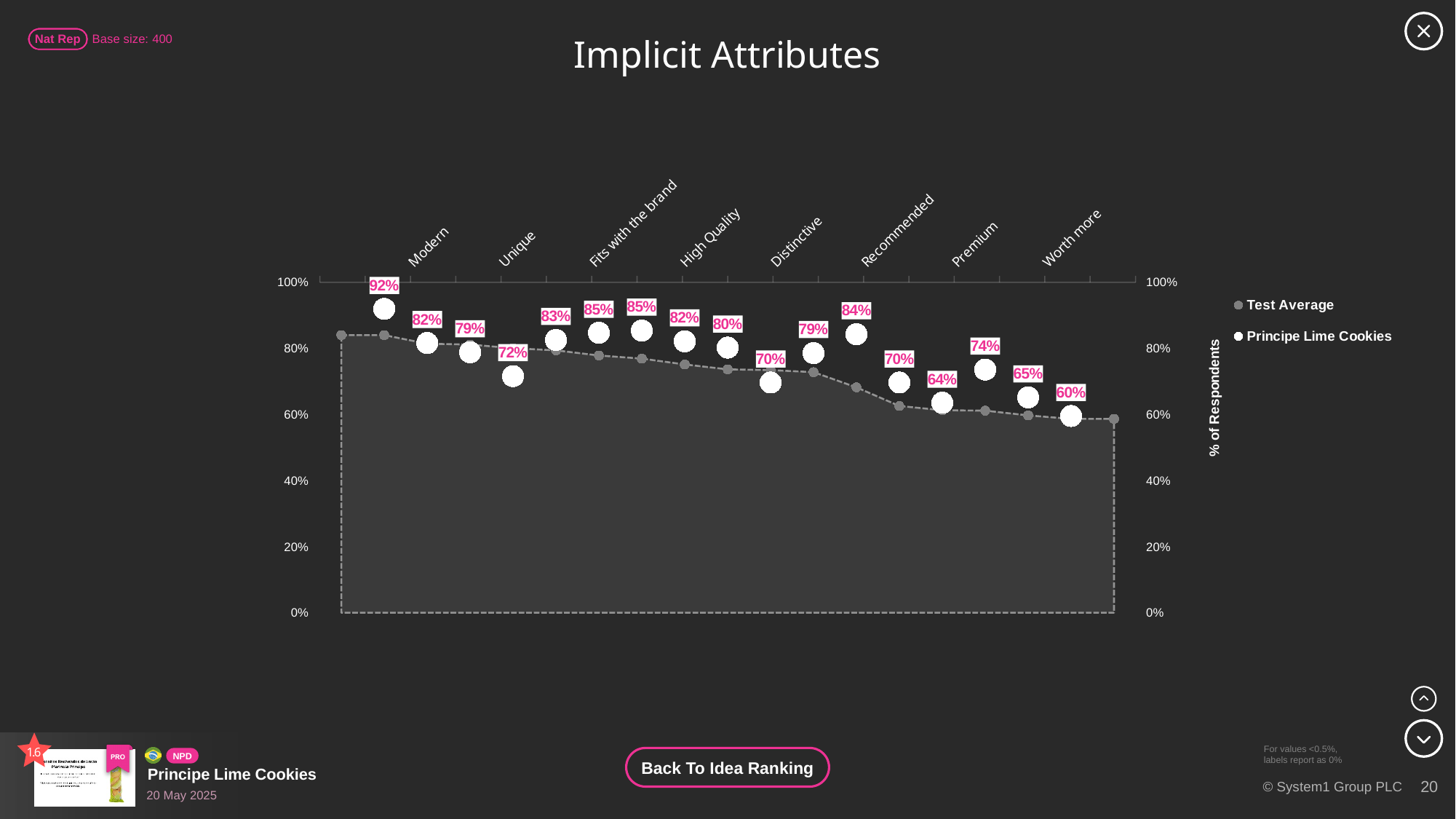
Which is larger: the first Principe Lime Cookies data label (92%) or the last one (60%)? The first (92%) How many series does the legend list on the Implicit Attributes chart? 2 Do the Principe Lime Cookies values generally rise or fall from left to right across the chart? Fall What is the highest data label shown for Principe Lime Cookies on the Implicit Attributes chart? 92% What is the label on the vertical axis of the chart? % of Respondents How many Principe Lime Cookies data labels are printed on the chart? 17 What are the two series named in the legend? Test Average and Principe Lime Cookies What is the lowest data label shown for Principe Lime Cookies on the Implicit Attributes chart? 60% What kind of chart is shown on the slide? Combination area and line chart Is the leftmost Test Average value greater or less than 80%? greater What is the difference between the highest (92%) and lowest (60%) Principe Lime Cookies data labels? 32 percentage points Is the Principe Lime Cookies value labeled 72% greater or less than 80%? less